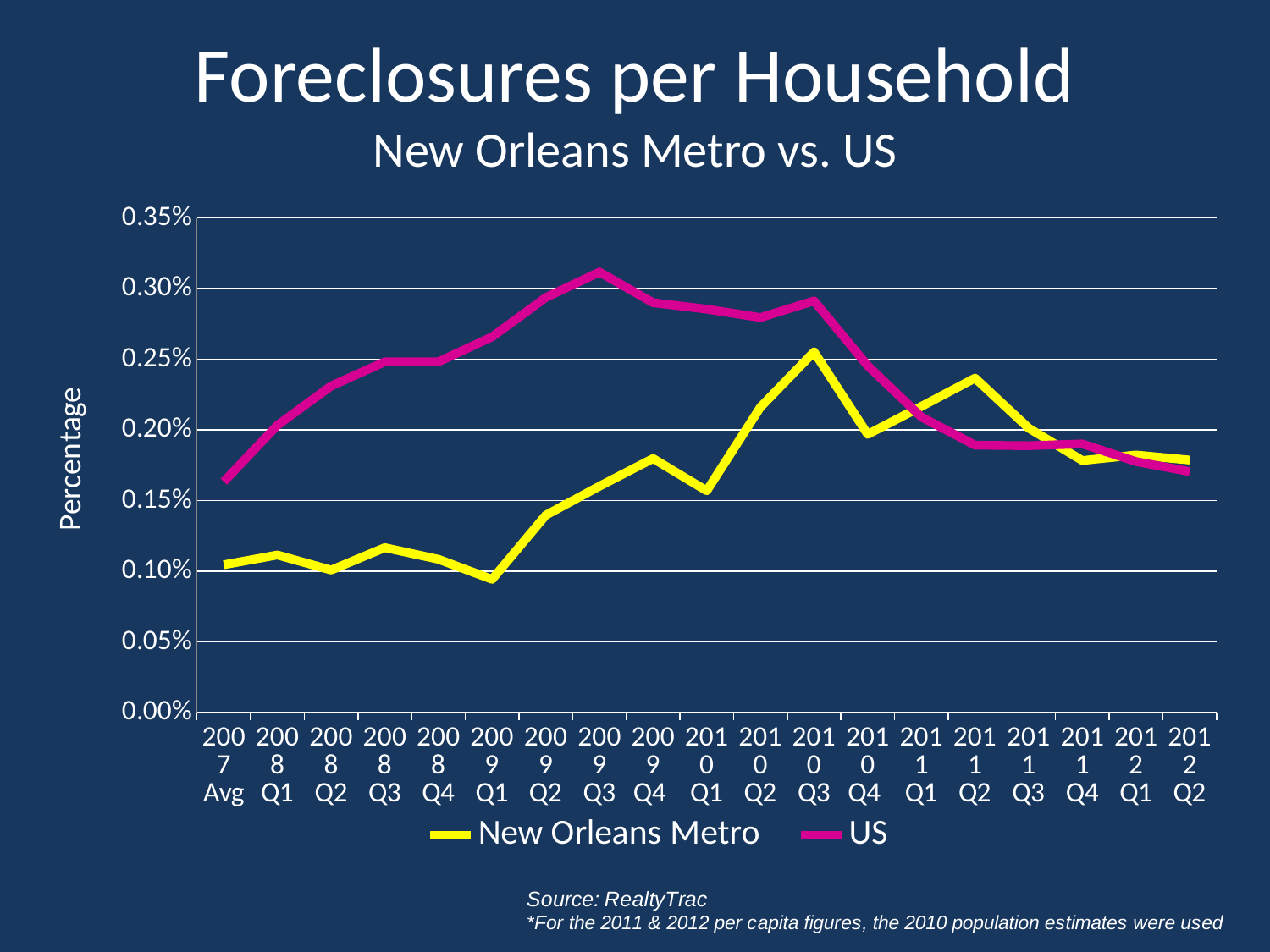
Is the US value for 2009 Q3 greater or less than 0.25%? greater How many time periods are plotted along the x axis? 19 In which period does the US series reach its highest value? 2009 Q3 In 2008 Q3, which series has the higher value, New Orleans Metro or US? US What kind of chart is shown on the slide? Line chart Is the New Orleans Metro value for 2007 Avg greater or less than 0.15%? less What are the two series named in the legend? New Orleans Metro and US What is the label on the vertical axis? Percentage Is the New Orleans Metro value for 2010 Q3 greater or less than 0.20%? greater How many series does the legend list? 2 In 2011 Q2, which series has the higher value, New Orleans Metro or US? New Orleans Metro